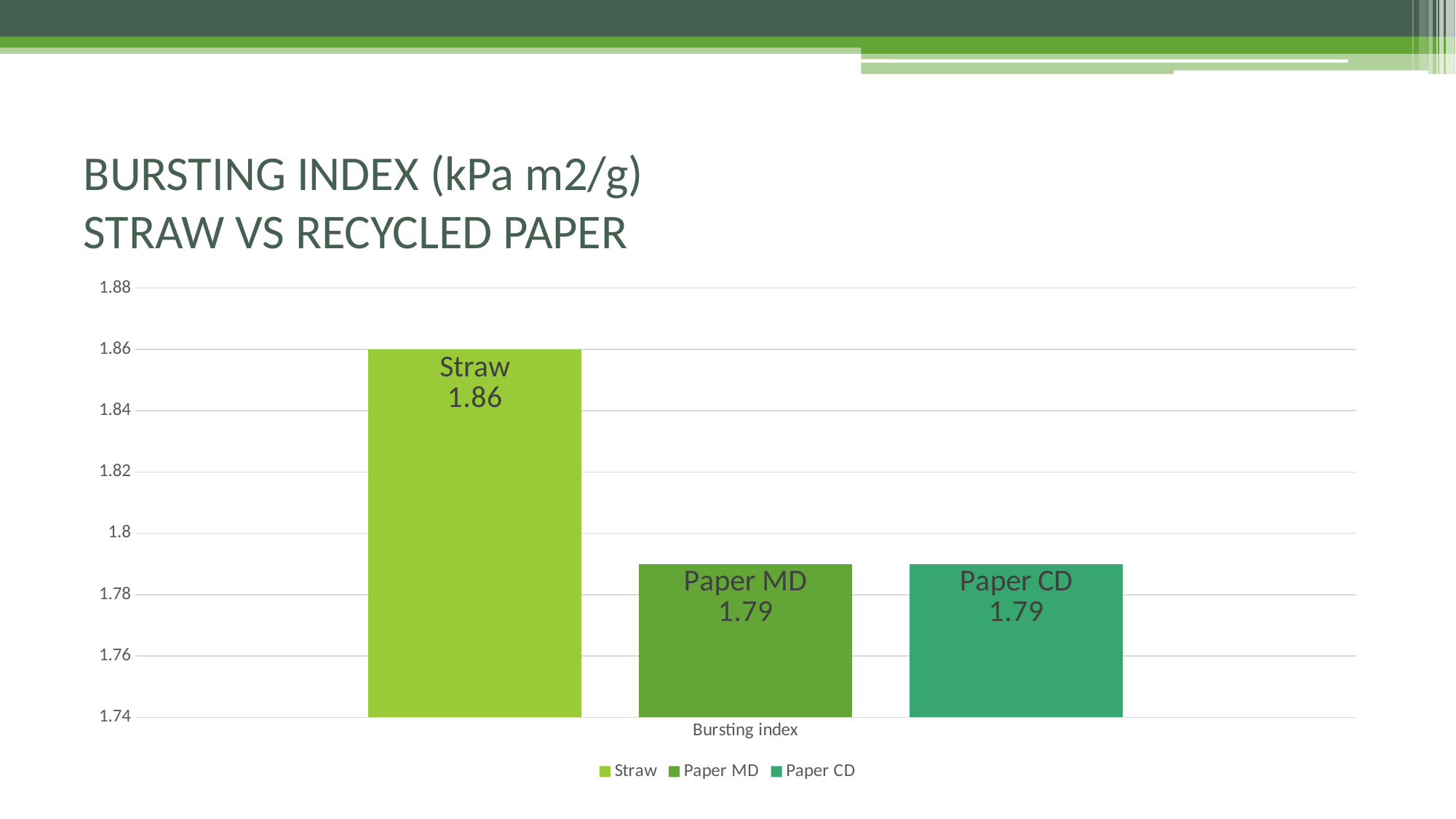
What kind of chart is shown on the slide? bar chart Is the value for Paper MD greater or less than 1.8? less Which series has the highest bursting index? Straw Is the value for Straw greater or less than 1.84? greater Which is larger, the bursting index of Straw or of Paper CD? Straw What is the title of the slide? BURSTING INDEX (kPa m2/g) STRAW VS RECYCLED PAPER What is the bursting index value for Paper CD? 1.79 What is the bursting index value for Paper MD? 1.79 What is the difference between the bursting index of Straw and Paper MD? 0.07 How many series does the legend list? 3 What is the label on the x axis of the chart? Bursting index What is the bursting index value for Straw? 1.86